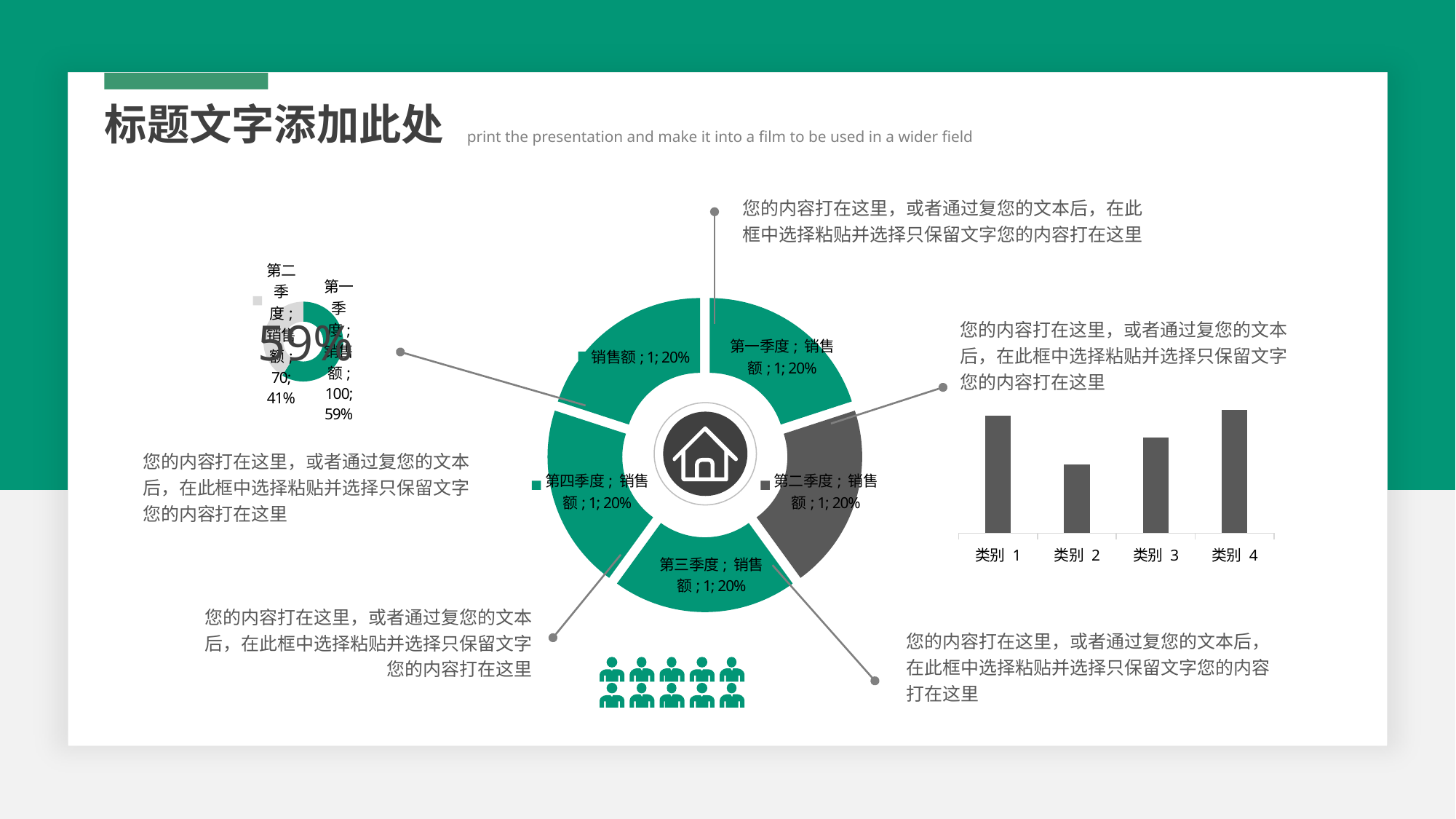
In the small doughnut chart on the left, what is the 销售额 value for 第一季度? 100 In the small doughnut chart on the left, what is the difference between the 销售额 values of 第一季度 and 第二季度? 30 In the bar chart on the right, which category has the shortest bar? 类别 2 What kind of chart is the chart on the right with 类别 1 to 类别 4? Bar chart In the bar chart on the right, which category has the tallest bar? 类别 4 In the large doughnut chart in the centre, which quarter's slice is coloured gray? 第二季度 In the bar chart on the right, which is larger, 类别 1 or 类别 3? 类别 1 In the large doughnut chart in the centre, how many slices are there? 5 In the large doughnut chart in the centre, what share does 第一季度 have? 20% In the small doughnut chart on the left, what share does 第二季度 have? 41% In the large doughnut chart in the centre, what is the 销售额 value for 第三季度? 1 In the bar chart on the right, how many categories are shown? 4